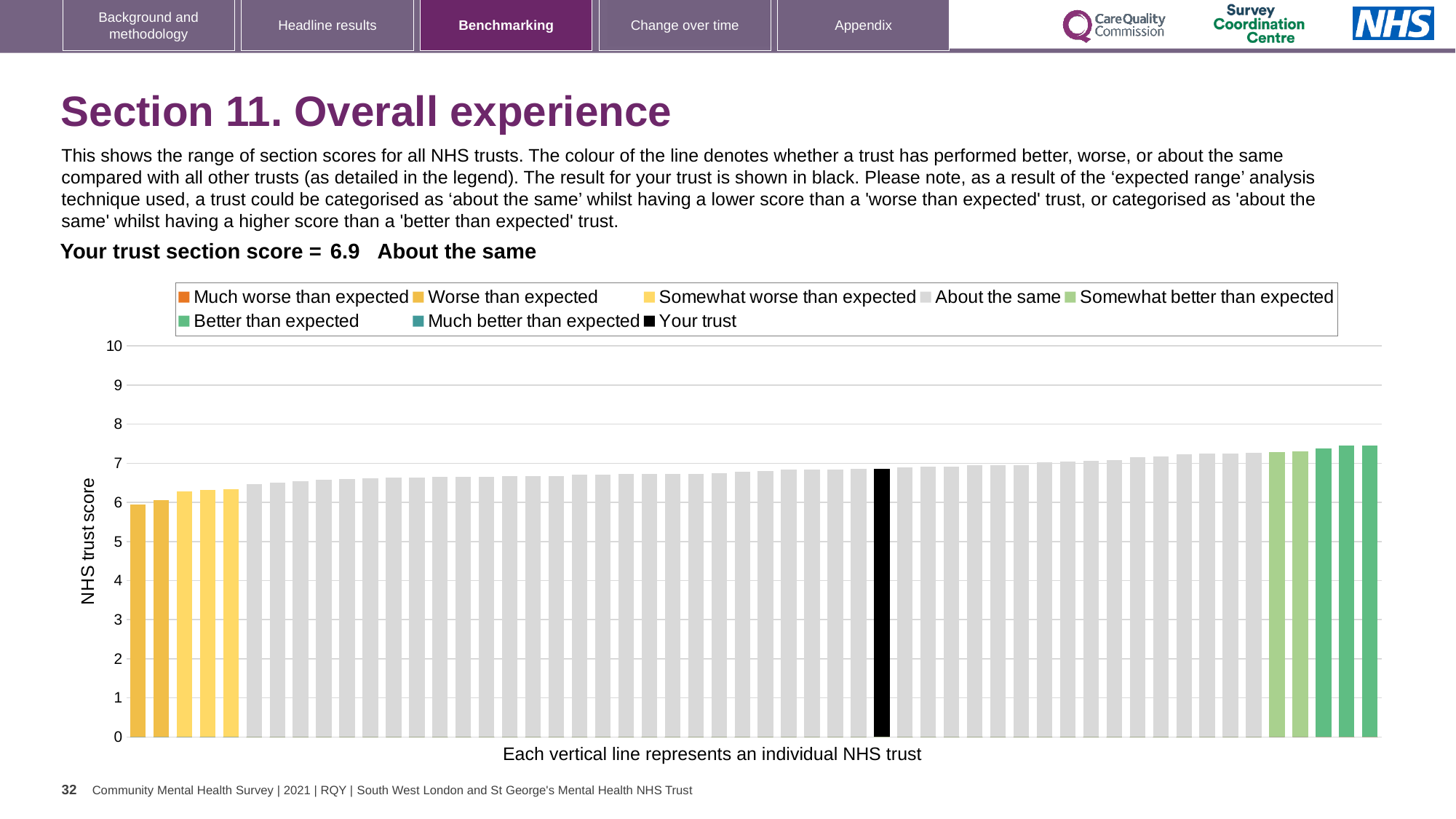
What colour is used for the bar representing your trust? black What is the section score for your trust shown on the slide? 6.9 Do the bar values rise or fall from left to right across the chart? rise What is the label on the vertical axis of the chart? NHS trust score Is the value of the tallest bar greater or less than 7? greater Is the value of the tallest bar greater or less than 8? less What kind of chart is shown on the slide? bar chart How many bars are shown in the 'Worse than expected' colour? 2 Is the value of the shortest bar greater or less than 5? greater Which benchmarking category is your trust placed in for this section? About the same Is your trust's bar (black) taller or shorter than the tallest bar on the chart? shorter How many entries does the chart legend list? 8